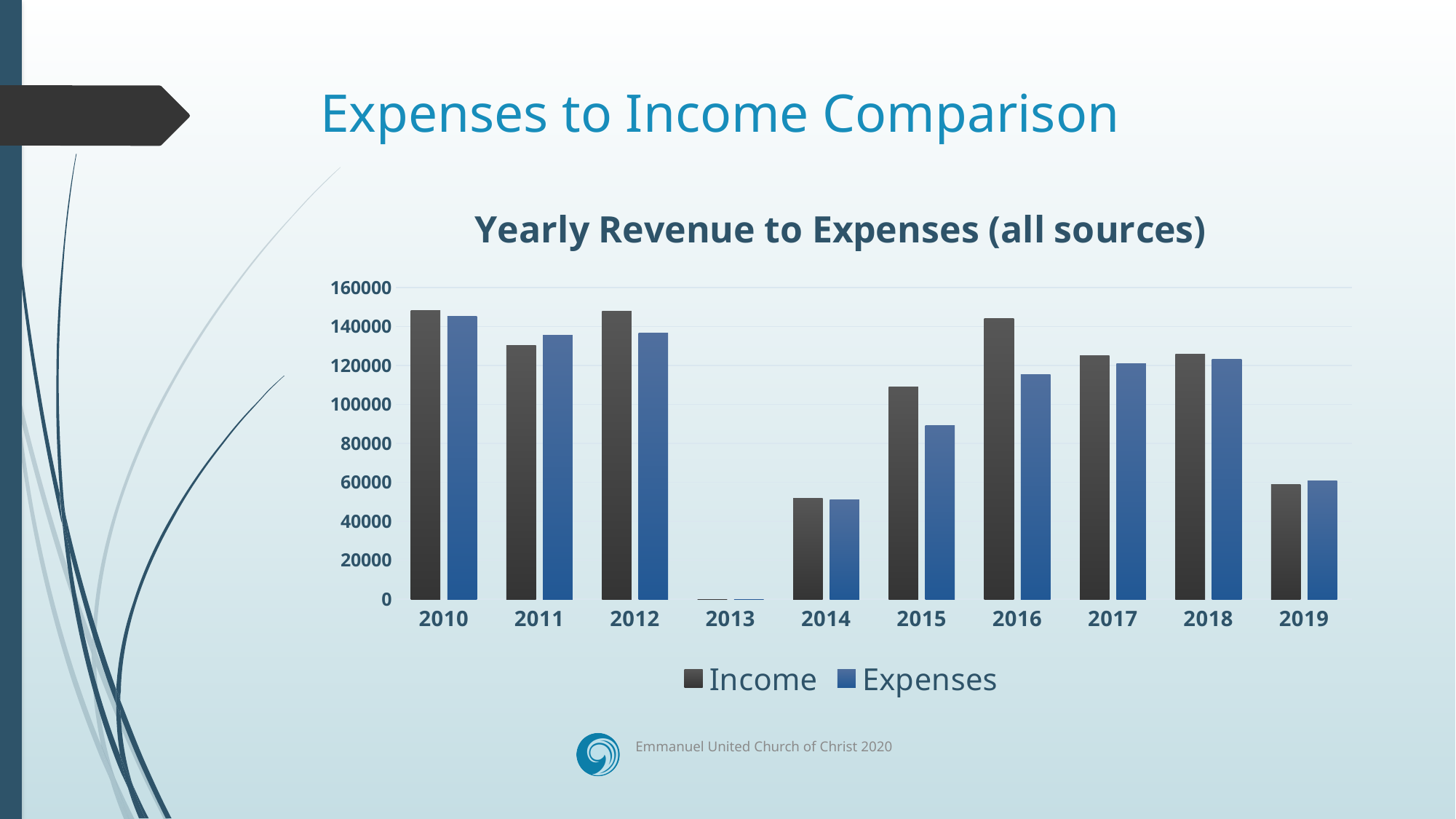
Which year has the highest Expenses value? 2010 What kind of chart is shown on the slide? bar chart Is the Expenses value for 2015 greater or less than 100000? less In 2016, which is larger, Income or Expenses? Income Is the Expenses value for 2012 greater or less than 120000? greater Is the Income value for 2014 greater or less than 60000? less How many years are shown on the x axis? 10 What is the title of the chart? Yearly Revenue to Expenses (all sources) In 2015, which is larger, Income or Expenses? Income How many series does the legend list? 2 Which year has the lowest Income value? 2013